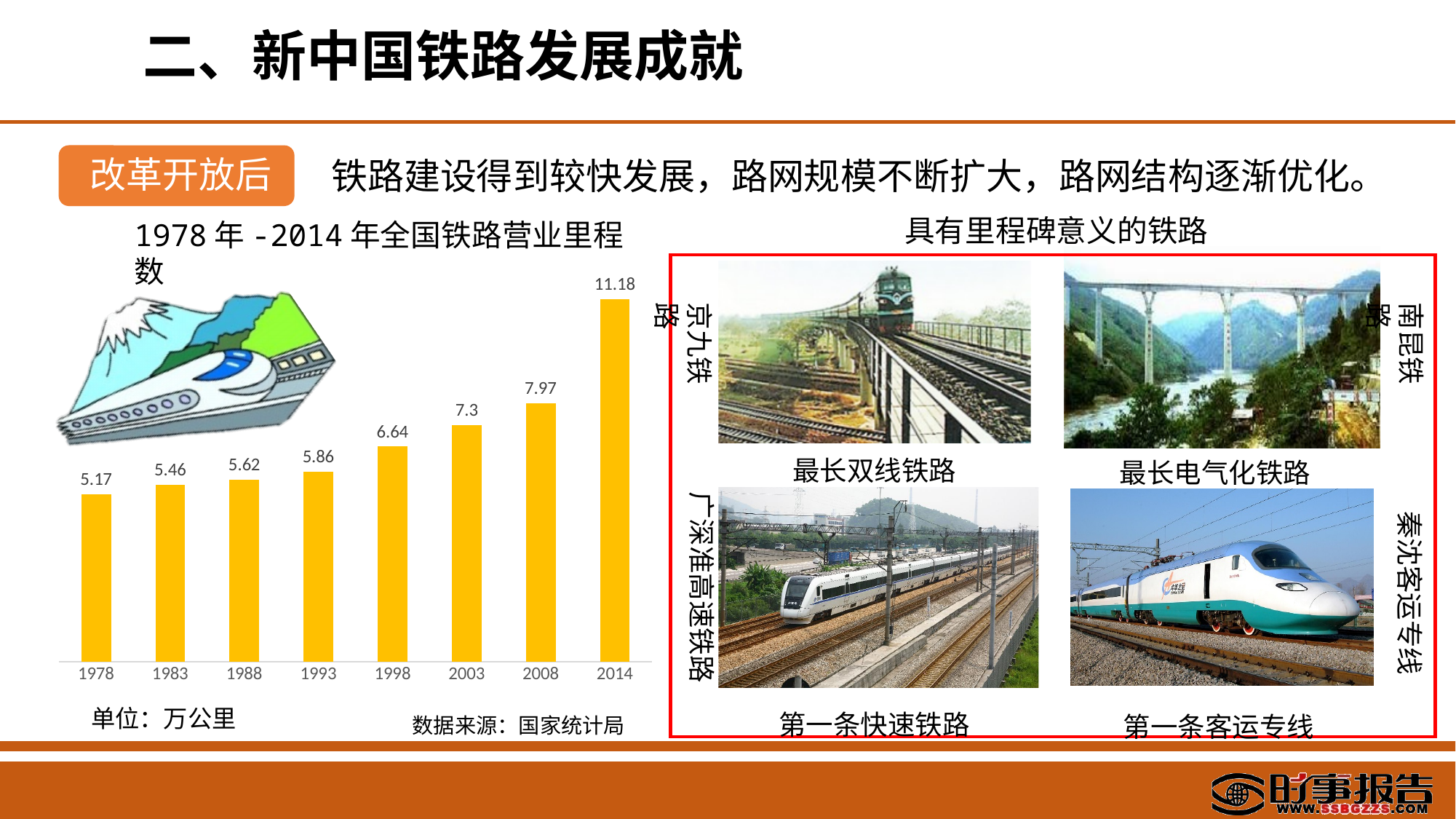
Do the values rise or fall from 1978 to 2014? rise What value is shown for 2008? 7.97 What type of chart is used to show the railway operating mileage? bar chart What is the difference between the values for 1993 and 1988? 0.24 Which year has the lowest railway operating mileage? 1978 Which year has the highest railway operating mileage? 2014 What was the national railway operating mileage in 1978? 5.17 What value is shown for 2014? 11.18 How many years are shown on the x axis of the chart? 8 What value is shown for 1998? 6.64 What is the difference between the values for 2014 and 2008? 3.21 Which is larger, the value for 2003 or the value for 1998? 2003